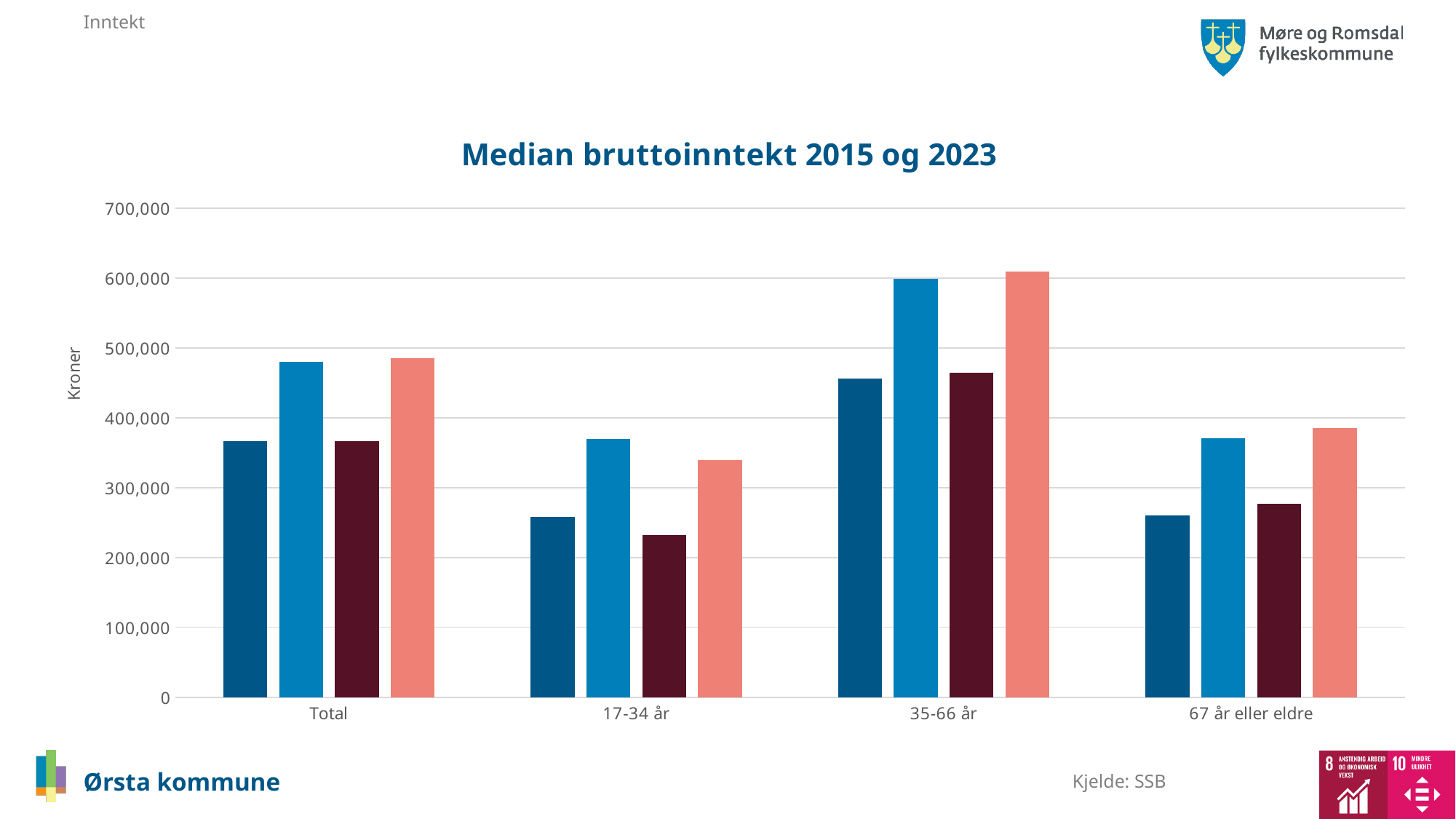
What is the title of the chart? Median bruttoinntekt 2015 og 2023 What is the label on the vertical axis of the chart? Kroner Which category contains the shortest bar in the chart? 17-34 år Which is larger: the light blue bar for 35-66 år or the light blue bar for Total? 35-66 år Is the dark red bar for 17-34 år greater or less than 300,000? less Is the salmon-coloured bar for 35-66 år greater or less than 600,000? greater How many categories are shown on the x axis of the chart? 4 Which is larger: the salmon-coloured bar for 17-34 år or the salmon-coloured bar for 67 år eller eldre? 67 år eller eldre Is the light blue bar for Total greater or less than 400,000? greater Which category contains the tallest bar in the chart? 35-66 år What kind of chart is shown on the slide? bar chart